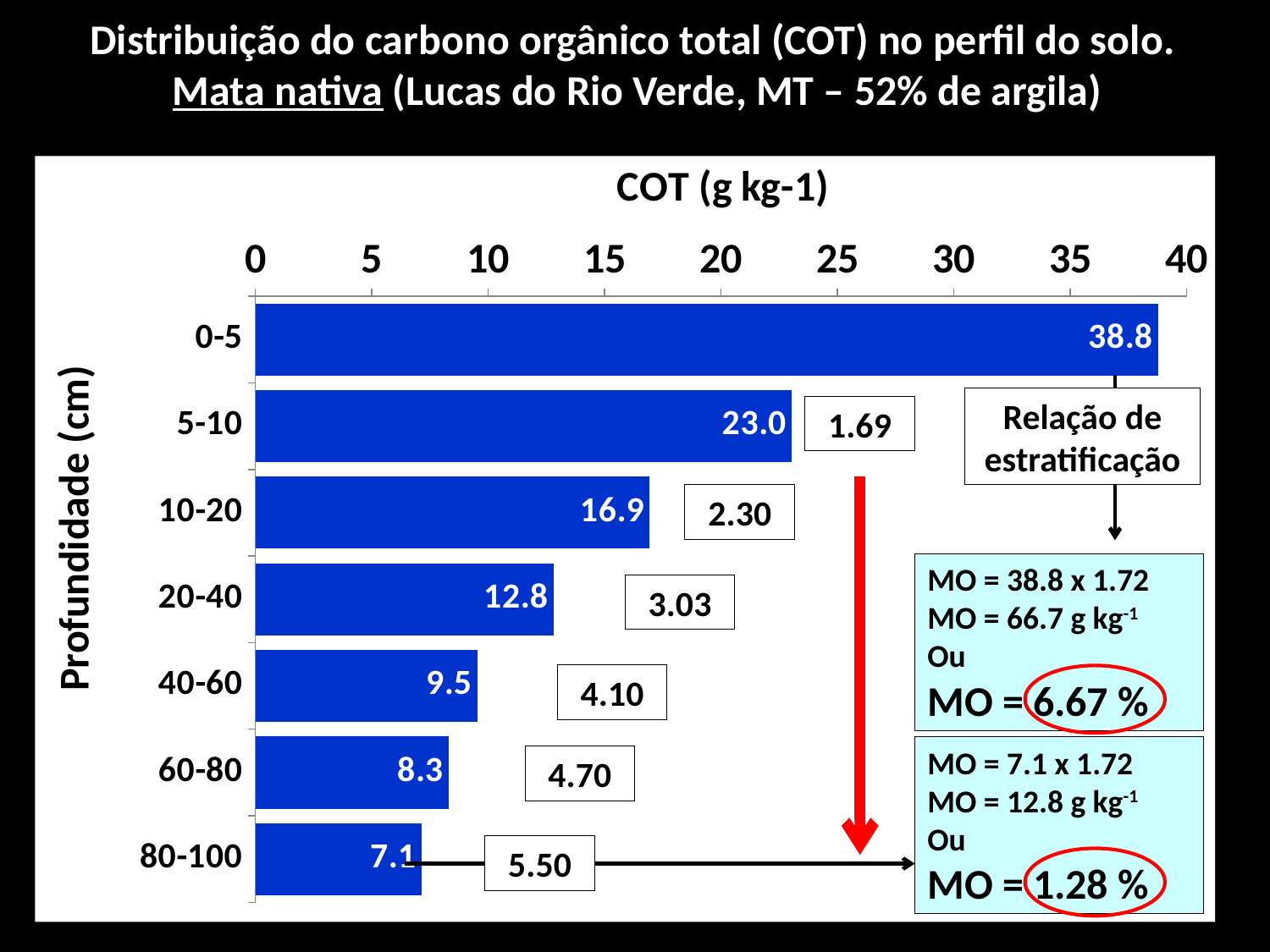
What is the label of the horizontal axis of the chart? COT (g kg-1) Is the COT value for 60-80 cm greater or less than 10? less Which depth has the highest COT value? 0-5 What kind of chart is shown on the slide? bar chart What is the difference between the COT values for 0-5 cm and 5-10 cm? 15.8 Which has a larger COT value, 10-20 cm or 40-60 cm? 10-20 Do the COT values rise or fall as depth increases from 0-5 cm to 80-100 cm? fall How many depth categories are shown in the chart? 7 Which depth has the lowest COT value? 80-100 What is the COT value for the 80-100 cm depth? 7.1 What is the COT value for the 0-5 cm depth? 38.8 What is the COT value for the 20-40 cm depth? 12.8